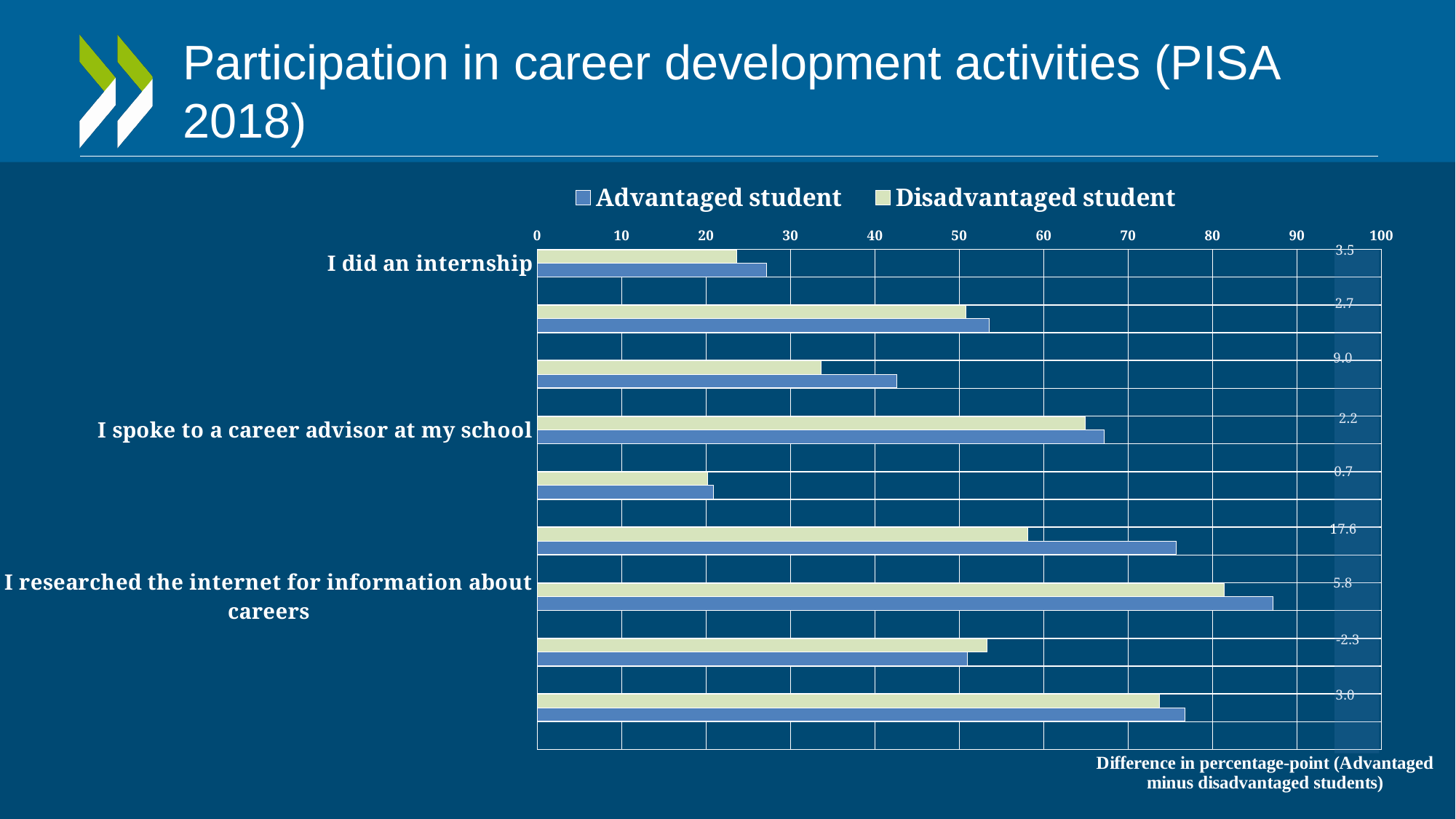
What is the difference in percentage-point shown for 'I spoke to a career advisor at my school'? 2.2 Is the value for Advantaged student on 'I did an internship' greater or less than 30? less What is the difference in percentage-point (advantaged minus disadvantaged students) shown for 'I did an internship'? 3.5 How many series does the legend list? 2 Is the value for Disadvantaged student on 'I researched the internet for information about careers' greater or less than 80? greater For 'I did an internship', which series has the larger value, Advantaged student or Disadvantaged student? Advantaged student What is the largest difference in percentage-point value printed on the chart? 17.6 What is the smallest difference in percentage-point value printed on the chart? -2.3 Which colour represents the Disadvantaged student series in the legend? light green What is the difference in percentage-point shown for 'I researched the internet for information about careers'? 5.8 How many groups of bars (categories) are plotted in the chart? 9 What kind of chart is shown on the slide? bar chart